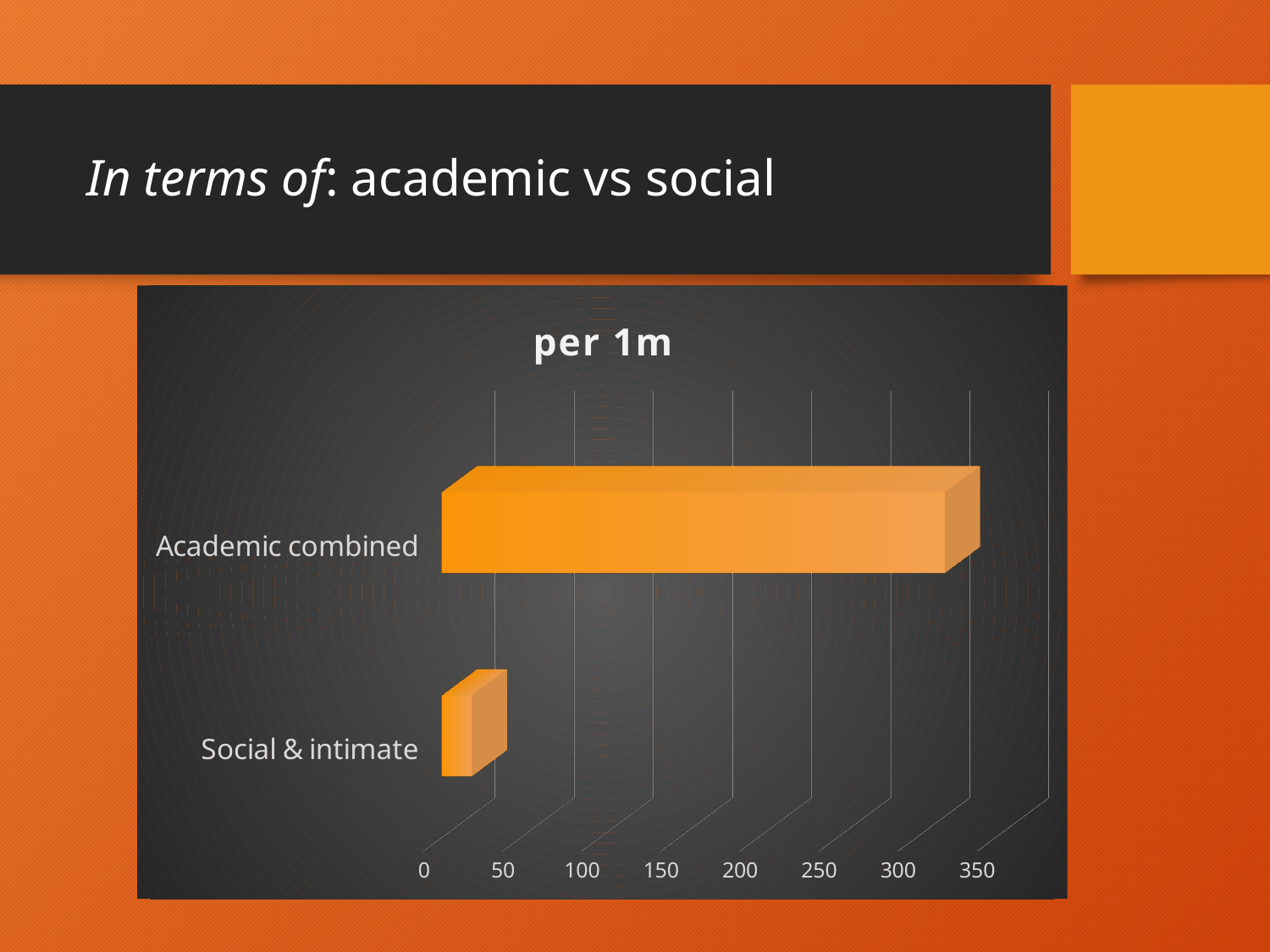
What is the highest value shown on the horizontal axis of the chart? 350 Which category has the lowest value in the chart? Social & intimate How many categories are plotted in the chart? 2 Which category has the highest value in the chart? Academic combined What type of chart is shown on the slide? bar chart Is the value for Social & intimate greater or less than 100? less Is the value for Social & intimate greater or less than 50? less What is the title of the chart? per 1m Is the value for Academic combined greater or less than 350? less Which is larger, the value for Academic combined or the value for Social & intimate? Academic combined